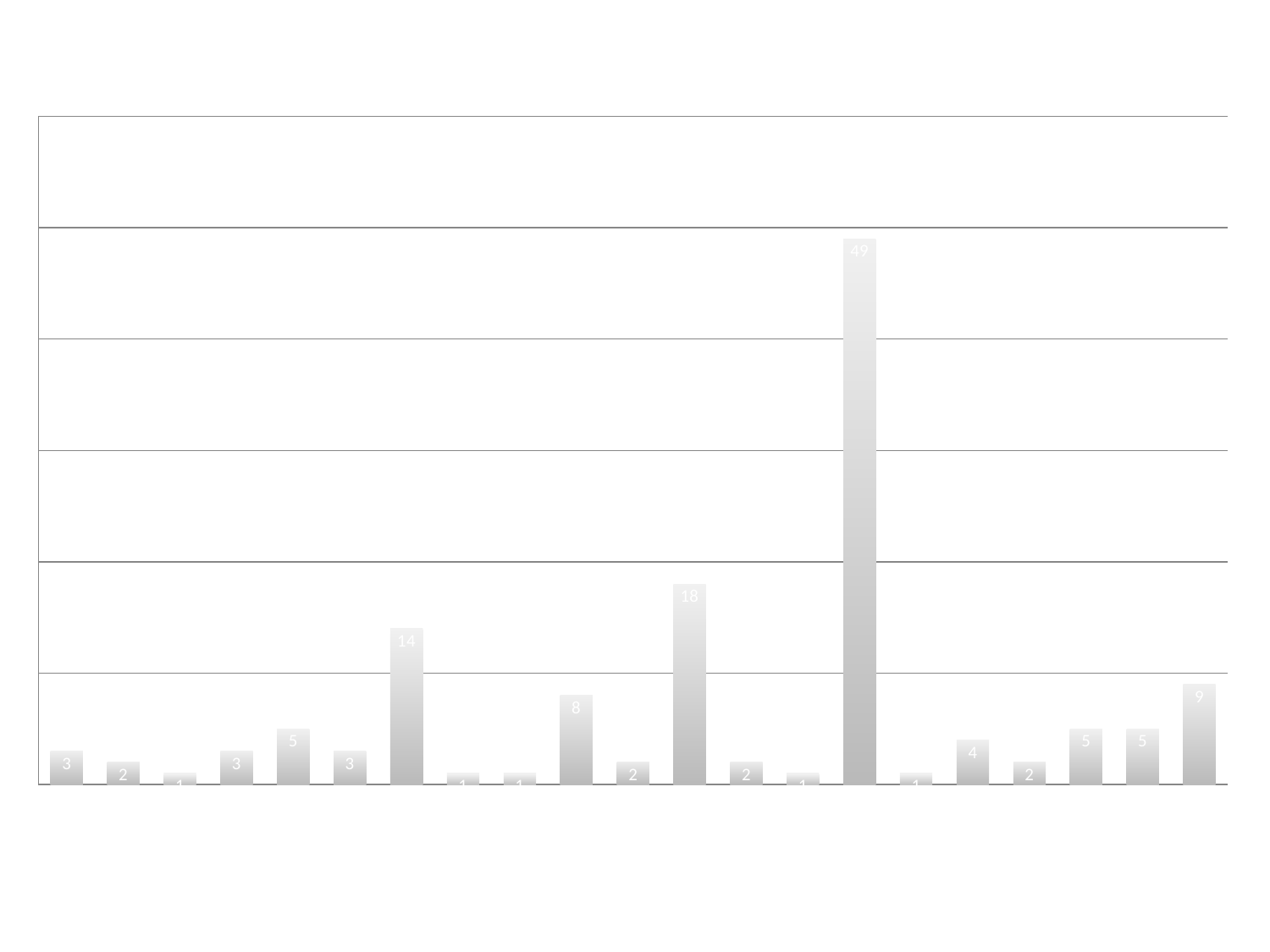
What is the value of the last bar on the right of the chart? 9 What is the difference between the tallest bar (49) and the second tallest bar (18)? 31 What is the smallest value labelled on any bar in the chart? 1 How many bars are plotted in the chart? 21 What is the value of the tallest bar in the chart? 49 What is the difference between the last bar on the right (9) and the first bar on the left (3)? 6 What is the value of the first bar on the left of the chart? 3 What is the value of the second tallest bar in the chart? 18 Which is larger: the bar labelled 14 or the bar labelled 18? the bar labelled 18 Does the chart display a legend? No How many bars in the chart are labelled with the value 1? 5 What kind of chart is shown on the slide? bar chart